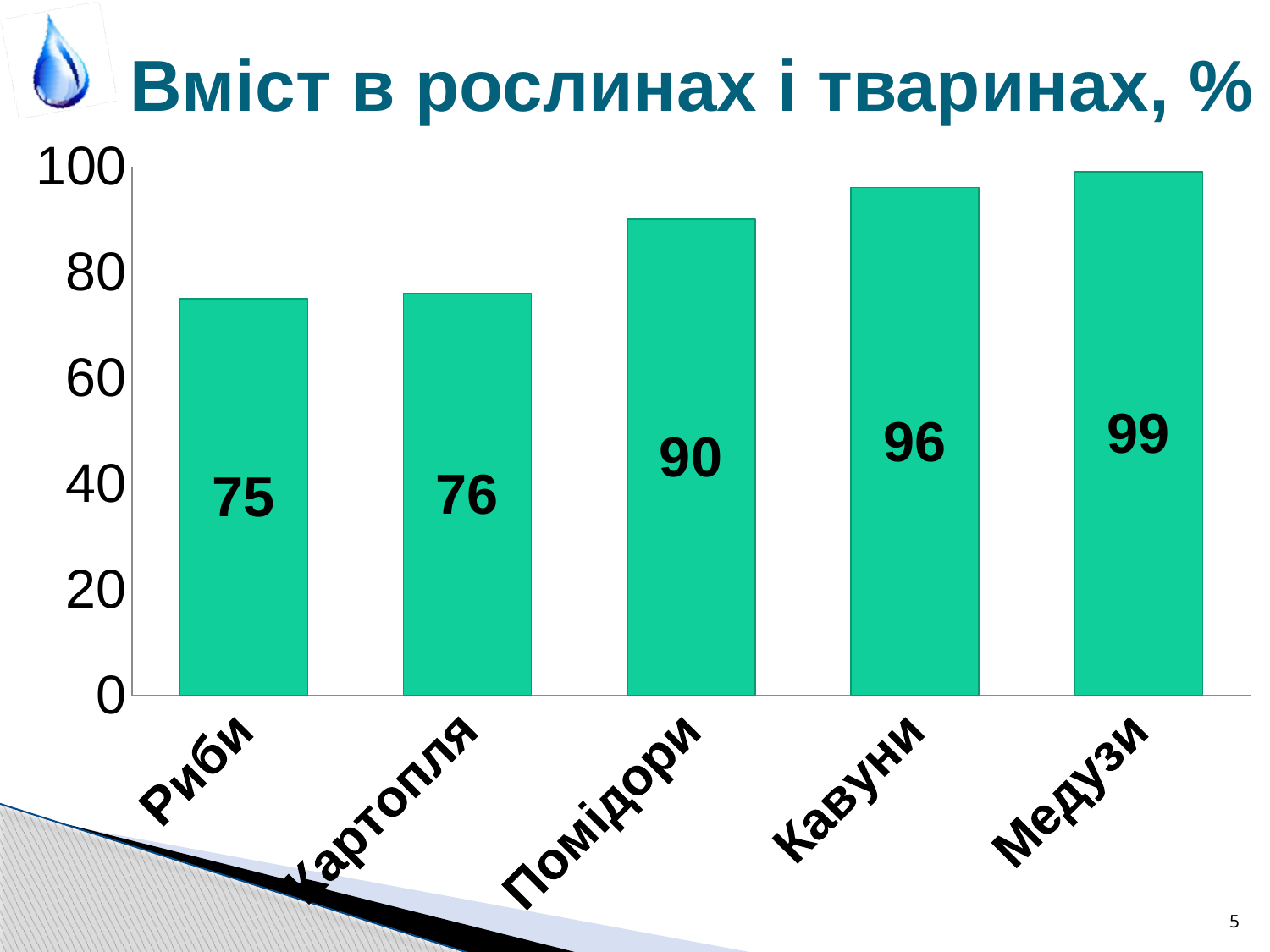
What is the difference between the values for Медузи and Риби? 24 What is the value for Помідори? 90 Is the value for Помідори greater or less than 80? greater What is the title of the chart? Вміст в рослинах і тваринах, % How many categories are shown on the chart? 5 What is the difference between the values for Кавуни and Помідори? 6 What kind of chart is shown on the slide? bar chart Which category has the highest value? Медузи Which category has the lowest value? Риби Which is larger, the value for Кавуни or the value for Картопля? Кавуни What is the value for Риби? 75 What is the value for Медузи? 99